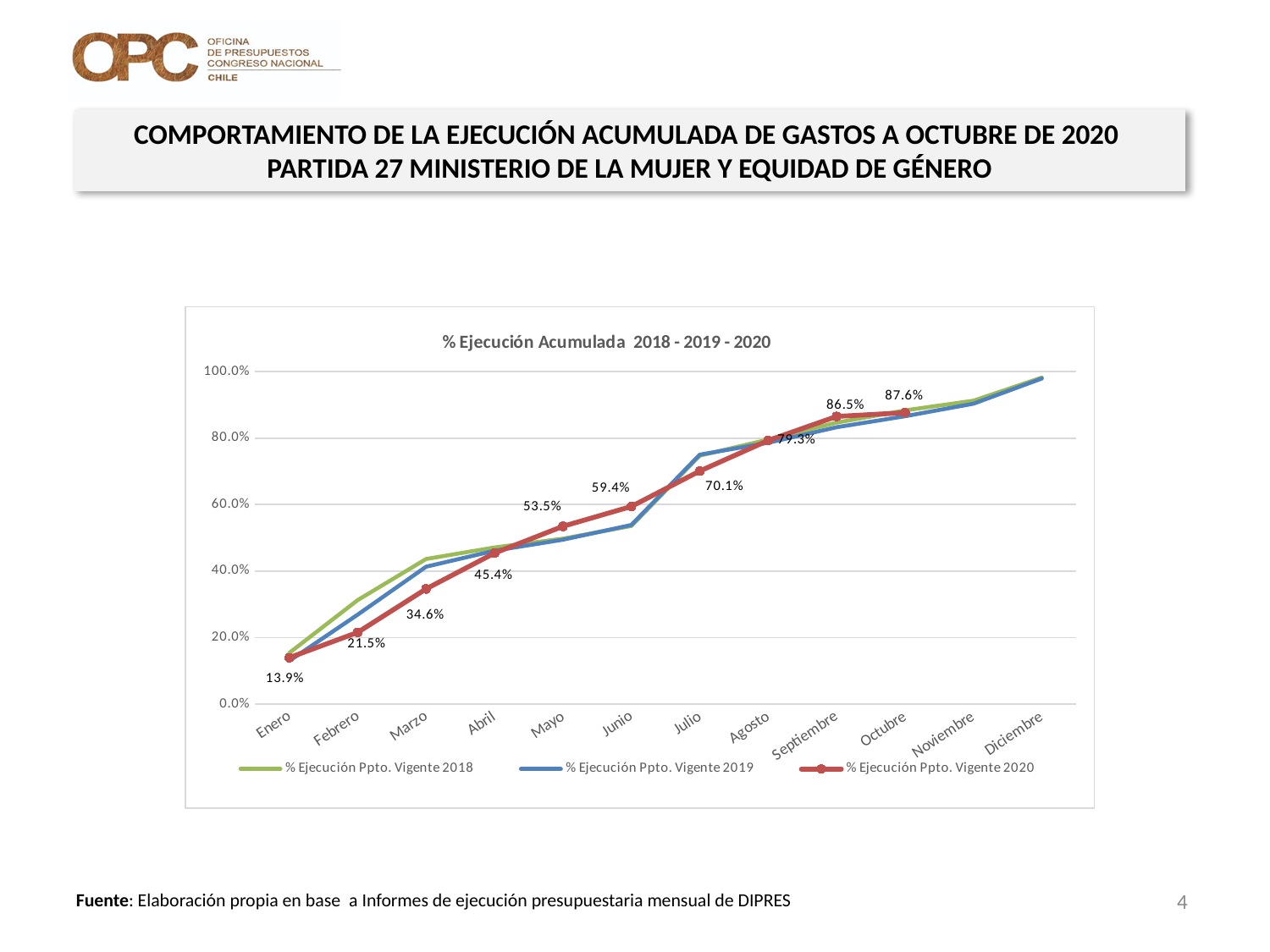
Does the % Ejecución Ppto. Vigente 2020 series rise or fall from Enero to Octubre? rise Is the value of % Ejecución Ppto. Vigente 2019 for Julio greater or less than 60.0%? greater What is the value of % Ejecución Ppto. Vigente 2020 for Mayo? 53.5% How many months are shown on the x axis? 12 What is the difference between the 2020 values for Octubre and Septiembre? 1.1% Which series is higher in Julio, % Ejecución Ppto. Vigente 2019 or % Ejecución Ppto. Vigente 2020? % Ejecución Ppto. Vigente 2019 What is the value of % Ejecución Ppto. Vigente 2020 for Octubre? 87.6% How many series does the legend list? 3 What is the title of the chart? % Ejecución Acumulada 2018 - 2019 - 2020 What type of chart is shown on the slide? line chart What is the value of % Ejecución Ppto. Vigente 2020 for Enero? 13.9% What is the difference between the 2020 values for Julio and Junio? 10.7%